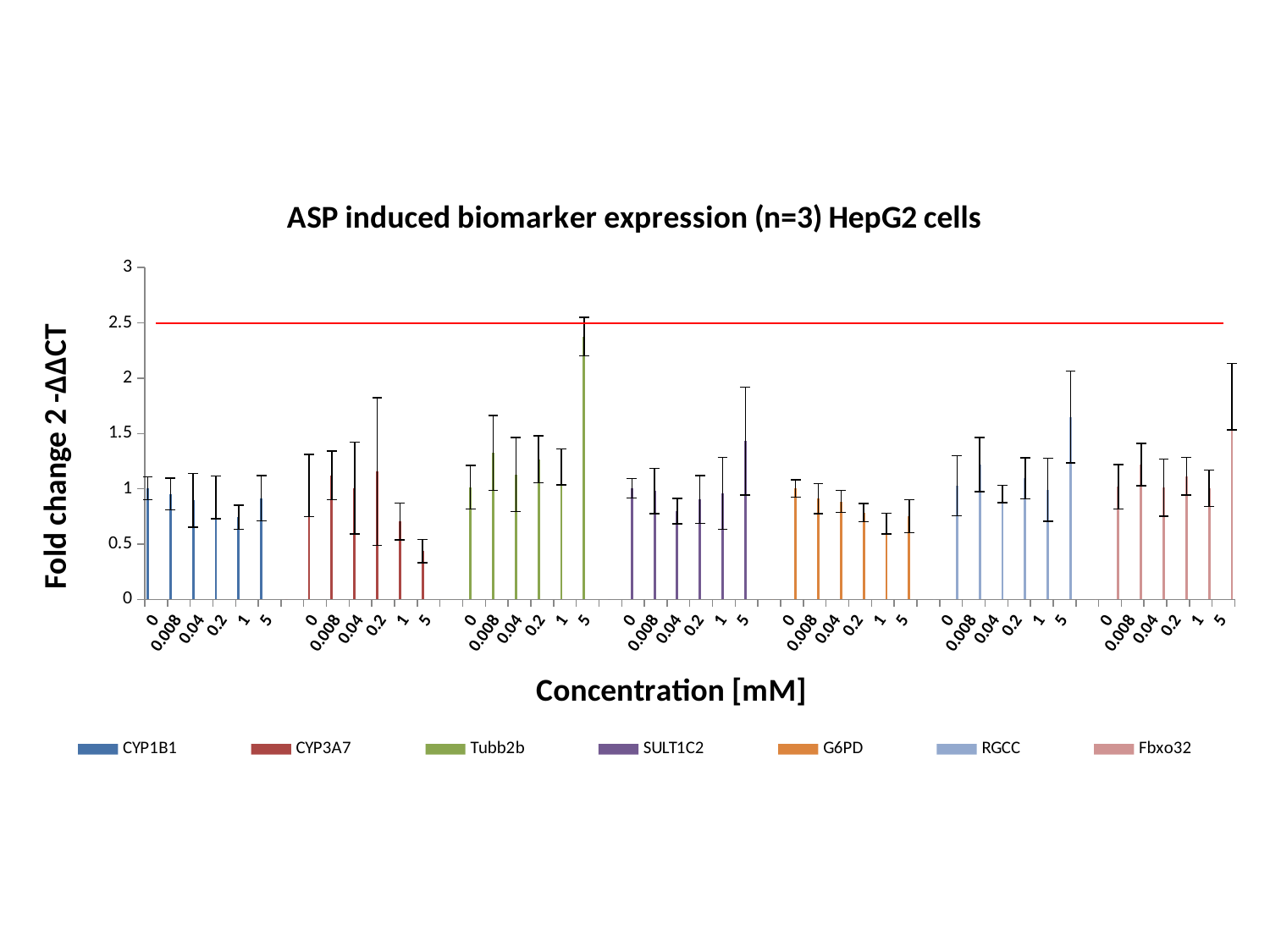
What is the title of the chart? ASP induced biomarker expression (n=3) HepG2 cells Is the fold change for G6PD at 1 mM greater or less than 1? less What kind of chart is shown on the slide? bar chart Which series and concentration has the lowest fold change bar? CYP3A7 at 5 mM How many series does the legend list? 7 Is the fold change for CYP3A7 at 5 mM greater or less than 1? less How many concentration levels are plotted for each biomarker series? 6 Is the fold change for Tubb2b at 5 mM greater or less than 2? greater Which series and concentration has the highest fold change bar? Tubb2b at 5 mM What is the label of the x axis? Concentration [mM] Which is larger, the fold change for Tubb2b at 5 mM or for CYP3A7 at 5 mM? Tubb2b at 5 mM